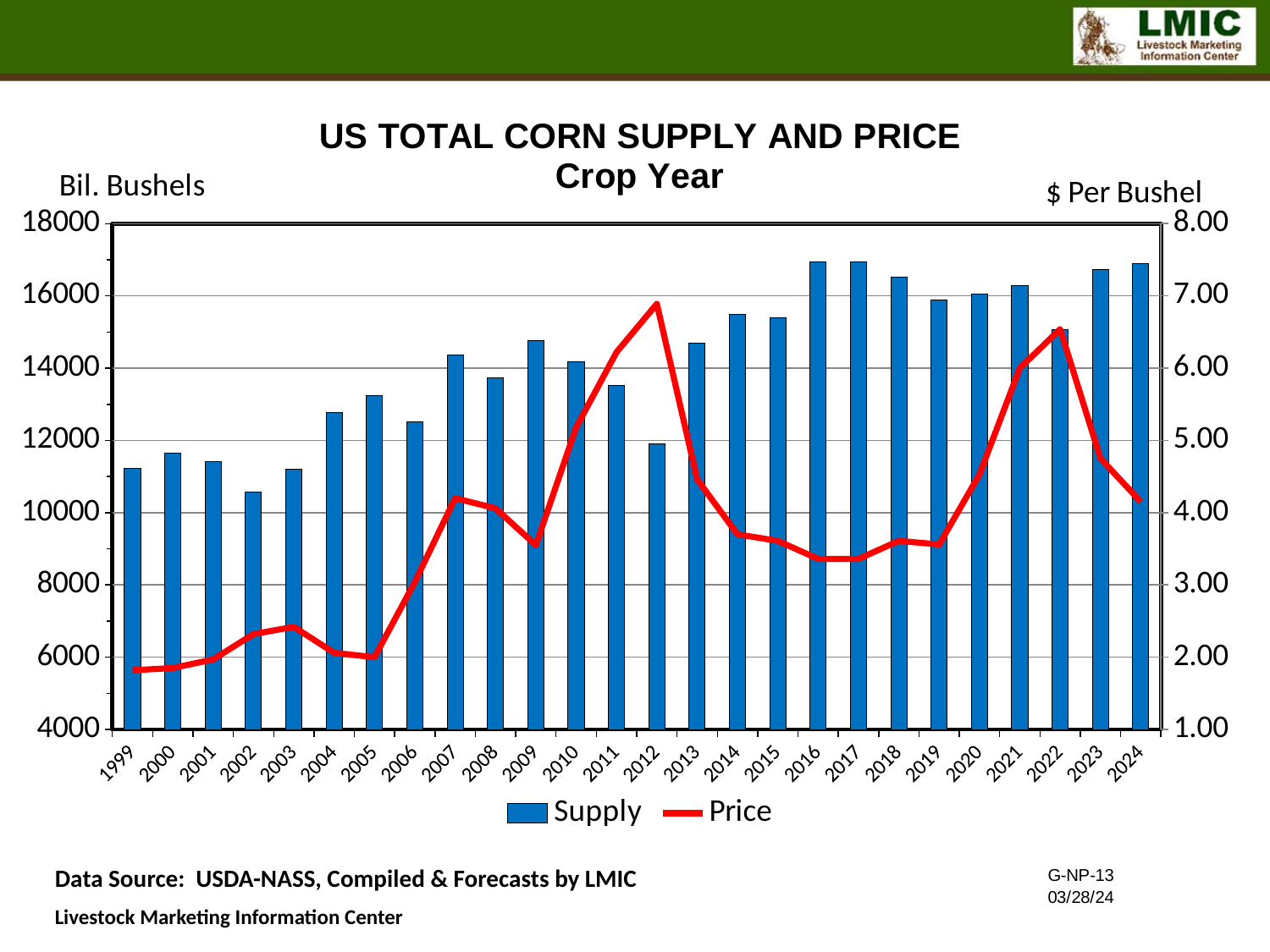
Which crop year has the highest Price? 2012 What kind of chart is shown on the slide? A combined bar and line chart Does the Price rise or fall from 2012 to 2016? fall Is the Price for 2005 greater or less than 3.00? less How many series does the legend list? 2 Which crop year has the lowest Supply? 2002 What unit is shown on the right-hand axis? $ Per Bushel Is the Price for 2012 greater or less than 6.00? greater How many crop years are shown on the x axis? 26 Is the Supply for 2016 greater or less than 16000? greater Which crop year has the larger Supply, 2012 or 2013? 2013